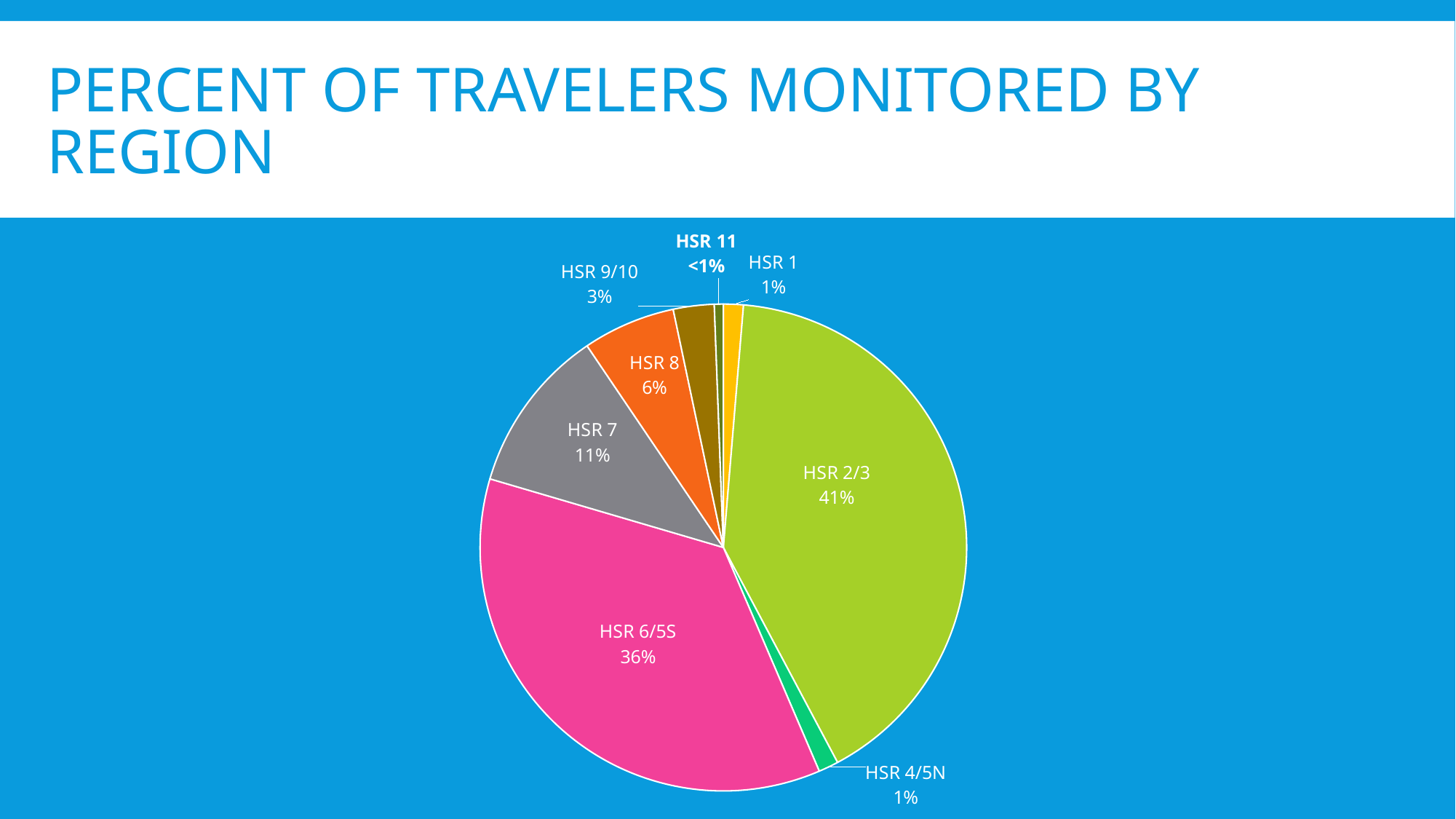
What is the difference in percentage points between HSR 2/3 and HSR 6/5S? 5 What percent of travelers monitored are in HSR 6/5S? 36% Which has a larger share, HSR 7 or HSR 8? HSR 7 How many regions (slices) are shown in the pie chart? 8 What percent of travelers monitored are in HSR 8? 6% What kind of chart is shown on the slide? pie chart What percent of travelers monitored are in HSR 2/3? 41% What percent of travelers monitored are in HSR 9/10? 3% What is the title of the chart? Percent of Travelers Monitored by Region What value is shown for HSR 11? <1% What percent of travelers monitored are in HSR 7? 11% Which region has the largest share of travelers monitored? HSR 2/3